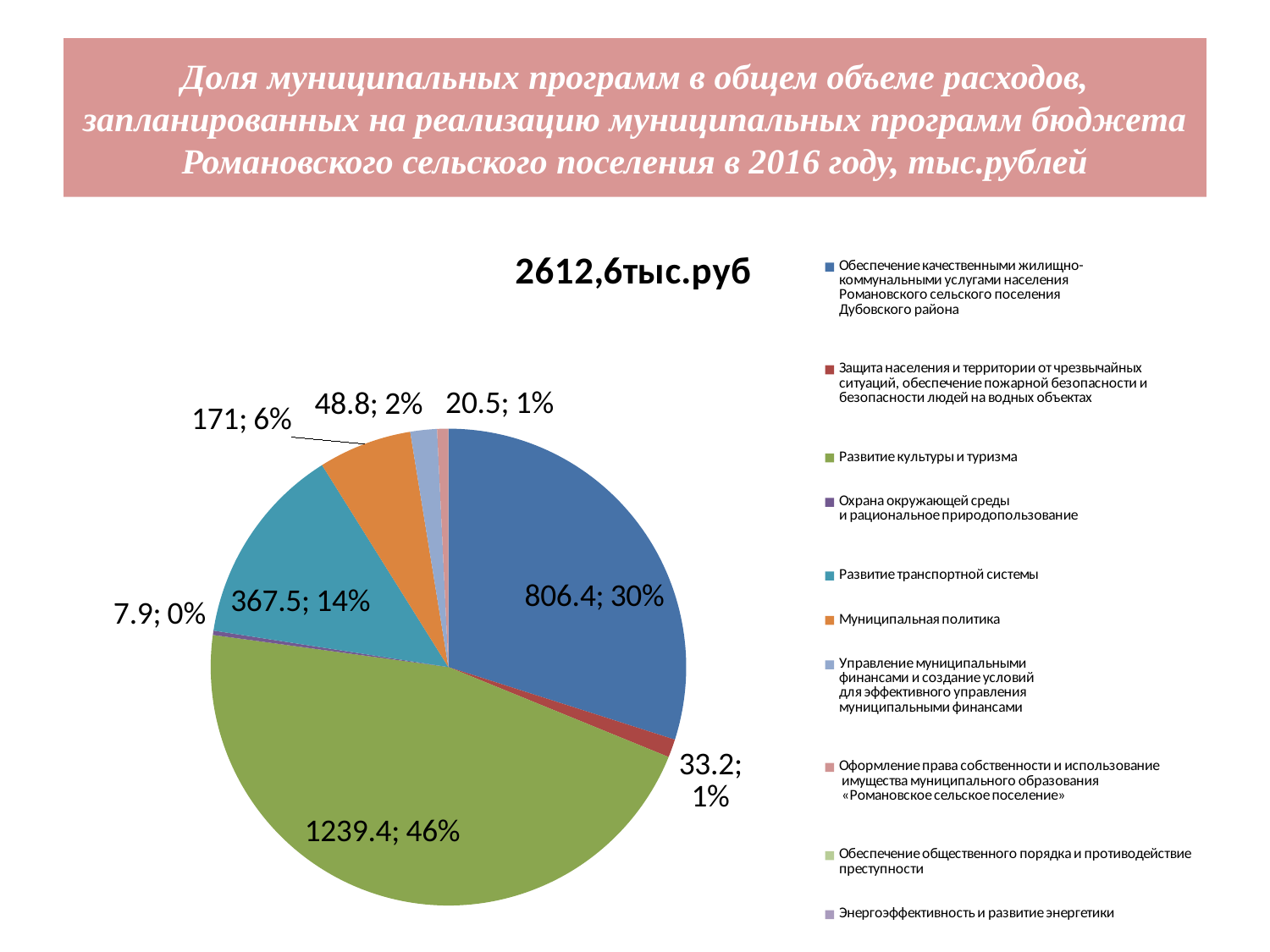
What share of the pie does «Обеспечение качественными жилищно-коммунальными услугами населения Романовского сельского поселения Дубовского района» represent? 30% What is the value for «Развитие культуры и туризма»? 1239.4 What is the difference between the values for «Развитие культуры и туризма» and «Обеспечение качественными жилищно-коммунальными услугами населения Романовского сельского поселения Дубовского района»? 433 What share of the pie does «Развитие транспортной системы» represent? 14% What total amount is shown as the chart title? 2612,6тыс.руб How many entries does the legend list? 10 What type of chart is shown on the slide? pie chart Which category has the largest slice of the pie? Развитие культуры и туризма What is the value for «Развитие транспортной системы»? 367.5 Which category has the smallest labelled slice of the pie? Охрана окружающей среды и рациональное природопользование What is the value for «Муниципальная политика»? 171 Which is larger: the value for «Муниципальная политика» or the value for «Управление муниципальными финансами и создание условий для эффективного управления муниципальными финансами»? Муниципальная политика